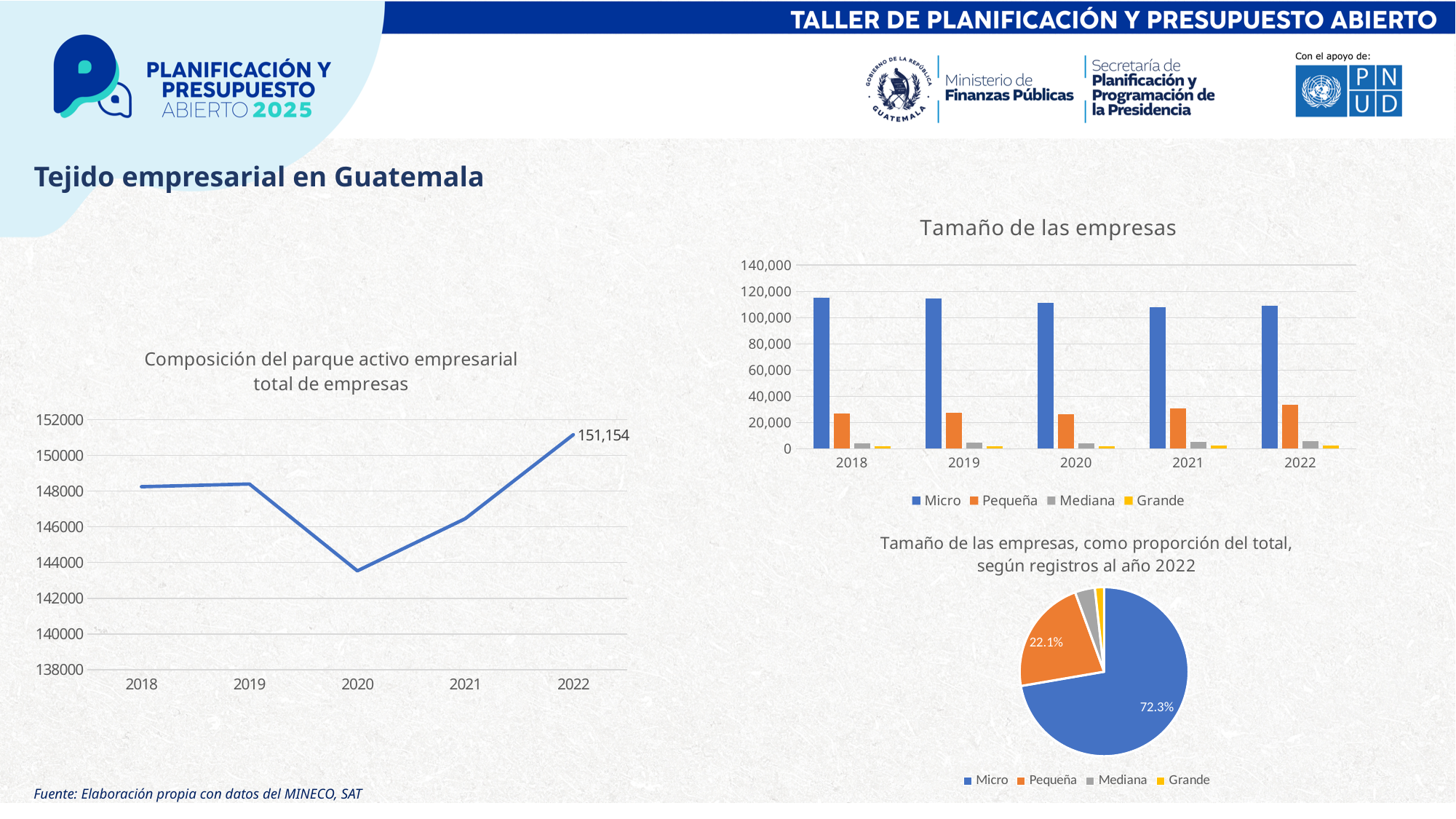
In the chart 'Composición del parque activo empresarial total de empresas', what is the value for 2022? 151,154 What kind of chart is 'Composición del parque activo empresarial total de empresas'? line chart In the chart 'Composición del parque activo empresarial total de empresas', does the value rise or fall from 2020 to 2022? rise In the pie chart 'Tamaño de las empresas, como proporción del total, según registros al año 2022', what share does Pequeña have? 22.1% In the chart 'Composición del parque activo empresarial total de empresas', which year has the highest value? 2022 In the pie chart 'Tamaño de las empresas, como proporción del total, según registros al año 2022', what share does Micro have? 72.3% In the chart 'Composición del parque activo empresarial total de empresas', which year has the lowest value? 2020 In the chart 'Composición del parque activo empresarial total de empresas', is the value for 2020 greater or less than 144000? less How many series does the legend of the chart 'Tamaño de las empresas' list? 4 In the chart 'Tamaño de las empresas', is the value for Pequeña in 2022 larger or smaller than the value for Pequeña in 2018? larger In the chart 'Tamaño de las empresas', is the value for Micro in 2018 greater or less than 100,000? greater In the chart 'Tamaño de las empresas', which series has the highest values in every year? Micro